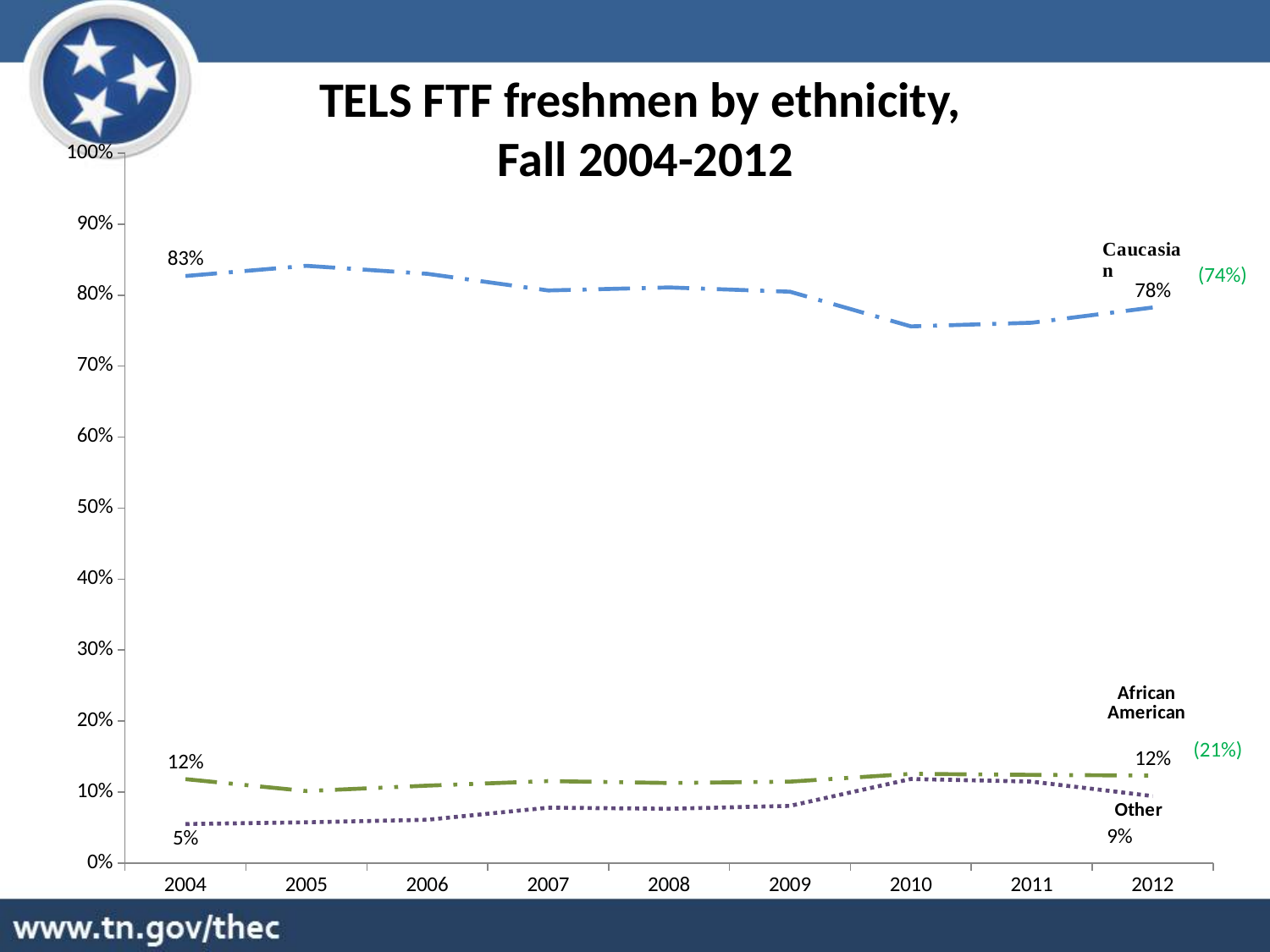
By how many percentage points did the Caucasian share fall from 2004 to 2012? 5 percentage points Did the Caucasian share of TELS FTF freshmen rise or fall between 2004 and 2012? fall What was the Other share of TELS FTF freshmen in Fall 2004? 5% Which ethnic group had the highest share of TELS FTF freshmen in 2012? Caucasian What kind of chart is shown on the slide? line chart What was the Caucasian share of TELS FTF freshmen in Fall 2012? 78% What was the Caucasian share of TELS FTF freshmen in Fall 2004? 83% What was the African American share of TELS FTF freshmen in Fall 2004? 12% What was the Other share of TELS FTF freshmen in Fall 2012? 9% What is the title of the chart? TELS FTF freshmen by ethnicity, Fall 2004-2012 By how many percentage points did the Other share rise from 2004 to 2012? 4 percentage points How many years are plotted along the x axis? 9